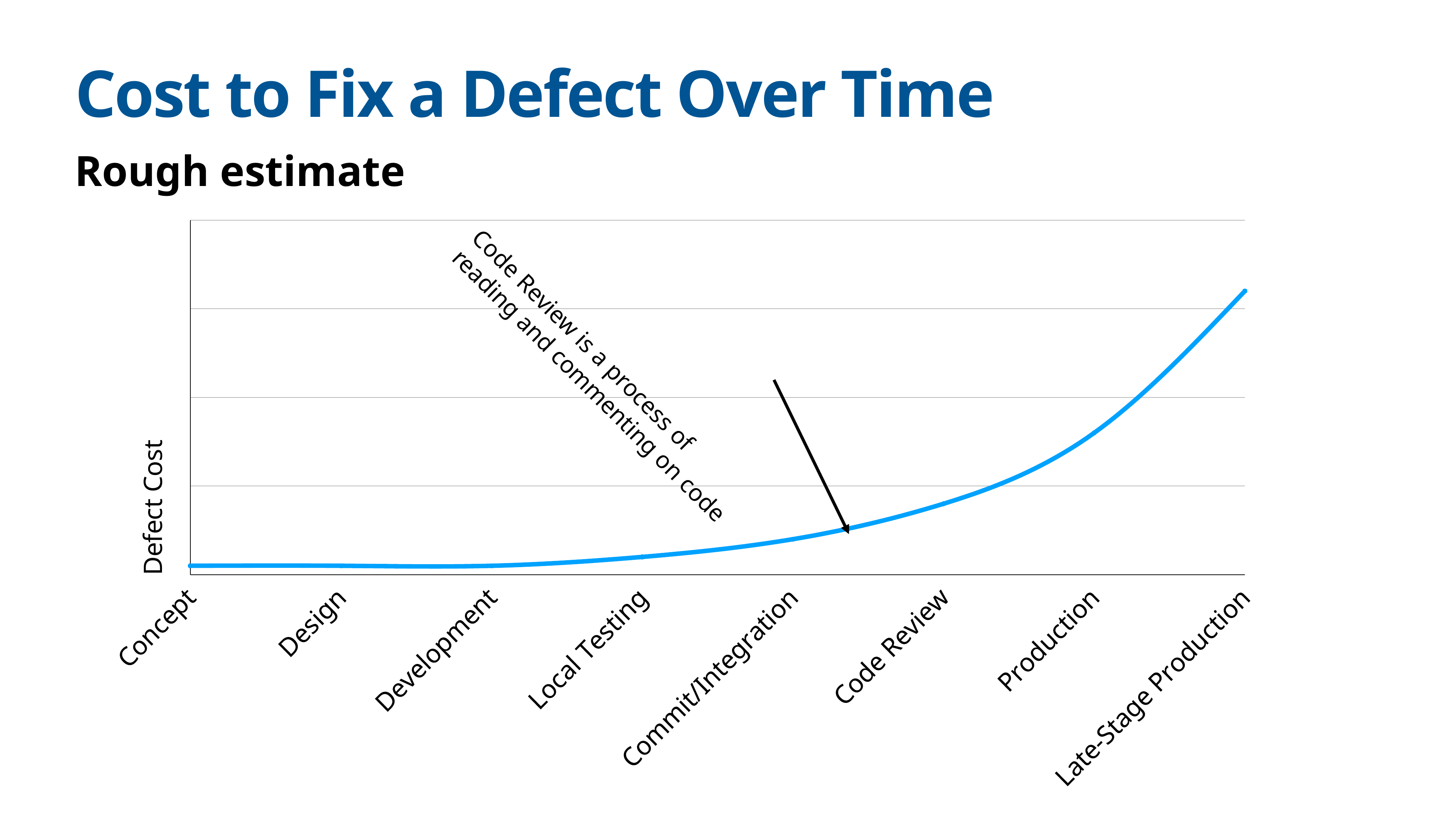
What kind of chart is shown on the slide? Line chart Which has a lower defect cost in the chart, Commit/Integration or Production? Commit/Integration How many categories are shown along the x axis of the chart? 8 What is the label on the y axis of the chart? Defect Cost What is the first category on the x axis of the chart? Concept Do the values in the chart rise or fall from Concept to Late-Stage Production? Rise Which has a higher defect cost in the chart, Code Review or Production? Production Which category does the black arrow in the chart point to on the line? Code Review Which has a higher defect cost in the chart, Local Testing or Late-Stage Production? Late-Stage Production Which category has the highest defect cost in the chart? Late-Stage Production What is the title of the chart on the slide? Cost to Fix a Defect Over Time